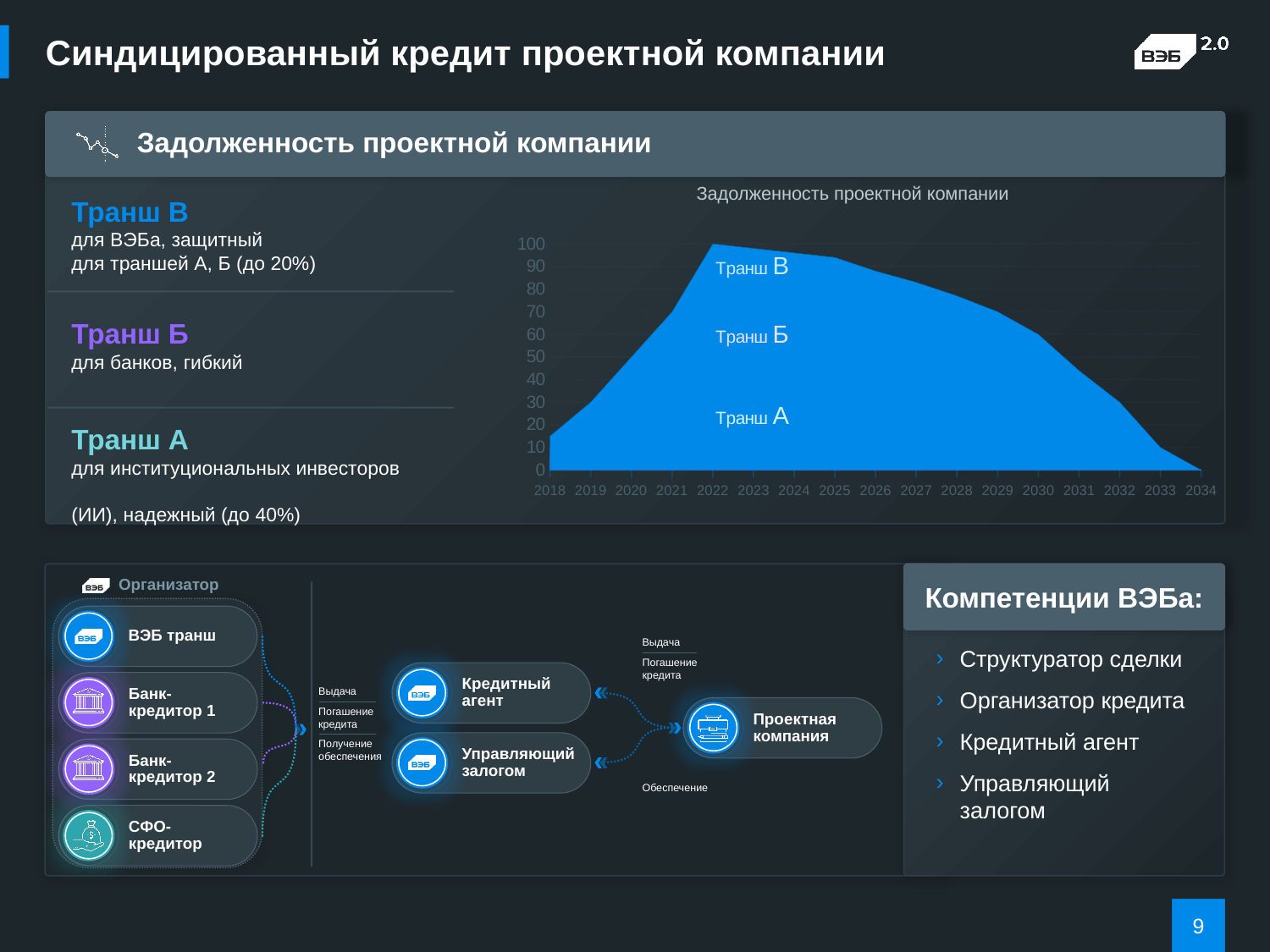
In which year does the chart reach its highest value? 2022 Do the values rise or fall along the x axis from 2018 to 2022? rise Is the value for 2033 greater or less than 20? less In which year does the chart reach its lowest value? 2034 Is the value for 2021 greater or less than 50? greater What is the title of the chart on the slide? Задолженность проектной компании Is the value for 2018 greater or less than 20? less Which year has the larger value, 2020 or 2028? 2028 Do the values rise or fall along the x axis from 2022 to 2034? fall Which three tranche labels are written inside the shaded area of the chart, from top to bottom? Транш В, Транш Б, Транш А How many years are shown on the x axis of the chart? 17 What kind of chart is shown under the heading "Задолженность проектной компании"? area chart